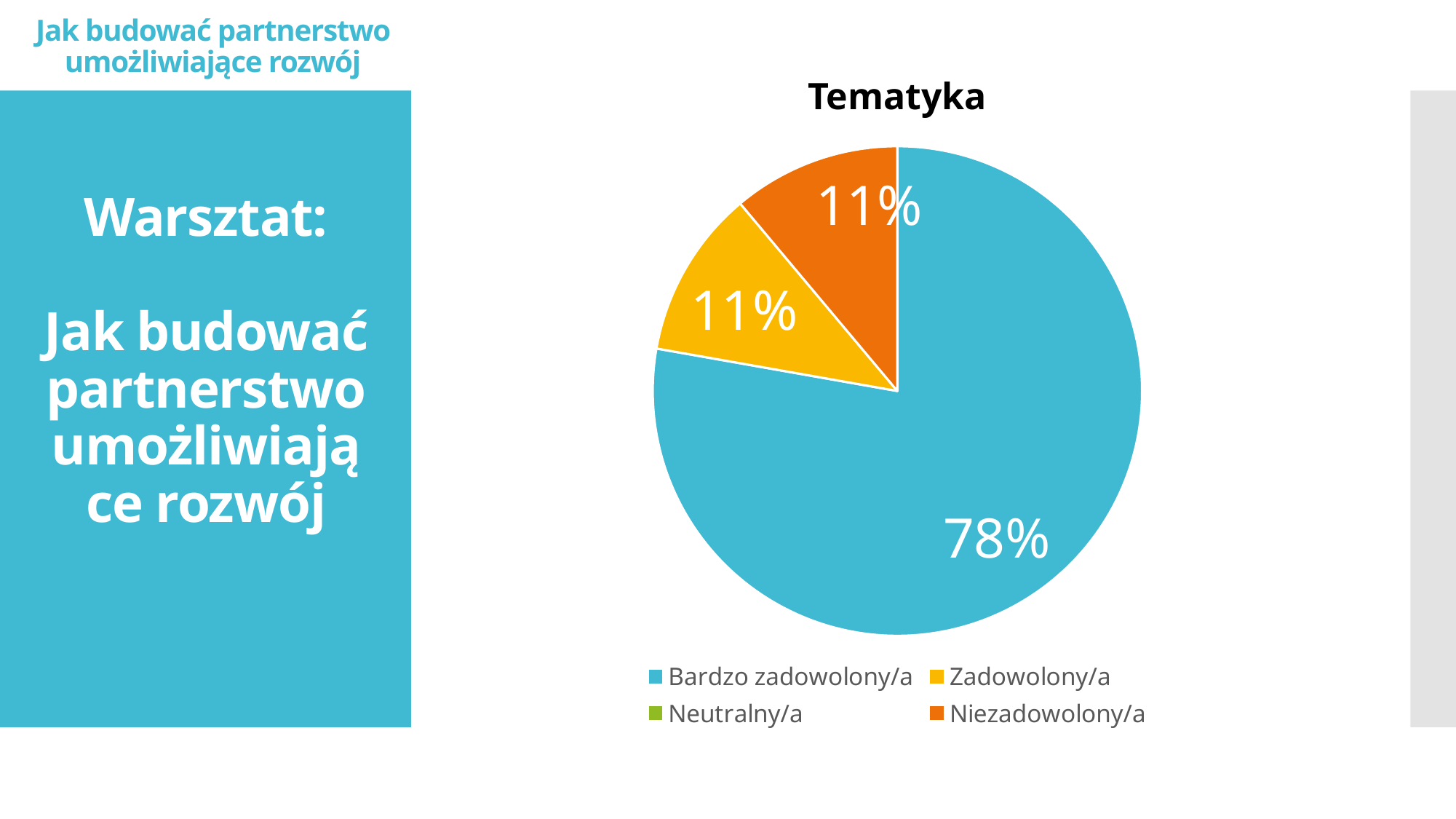
What is the title of the chart? Tematyka What is the difference in percentage points between the Bardzo zadowolony/a slice and the Zadowolony/a slice? 67 Which is larger, the Bardzo zadowolony/a slice or the Niezadowolony/a slice? Bardzo zadowolony/a What share of the pie is labelled for Zadowolony/a? 11% What share of the pie is labelled for Bardzo zadowolony/a? 78% What share of the pie is labelled for Niezadowolony/a? 11% Which category has the largest slice of the pie? Bardzo zadowolony/a What colour is the Bardzo zadowolony/a slice? blue What type of chart is shown on the slide? pie chart How many slices are visible in the pie? 3 How many entries does the legend list? 4 Is the share for Bardzo zadowolony/a greater or less than 50%? greater